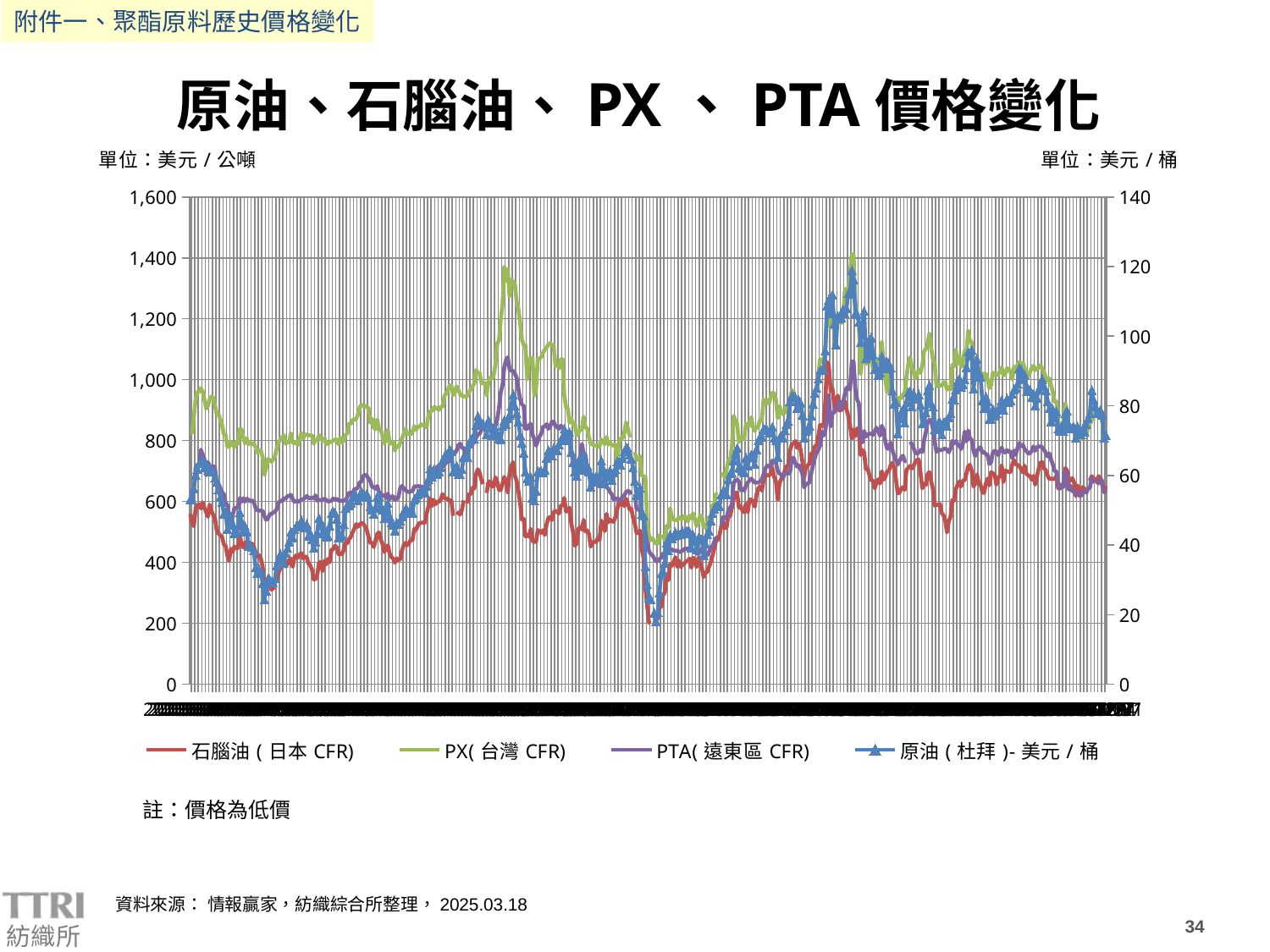
Is the lowest value of the 石腦油(日本 CFR) series greater or less than 600? less Is the peak value of the PX(台灣 CFR) series greater or less than 1,200? greater Which series is plotted against the right-hand axis in 美元/桶? 原油(杜拜) Which series generally sits highest on the chart, PX(台灣 CFR) or 石腦油(日本 CFR)? PX(台灣 CFR) What kind of chart is shown on the slide? line chart Is the peak value of the PTA(遠東區 CFR) series greater or less than 1,200? less What is the title of the chart? 原油、石腦油、PX、PTA 價格變化 How many series does the legend list? 4